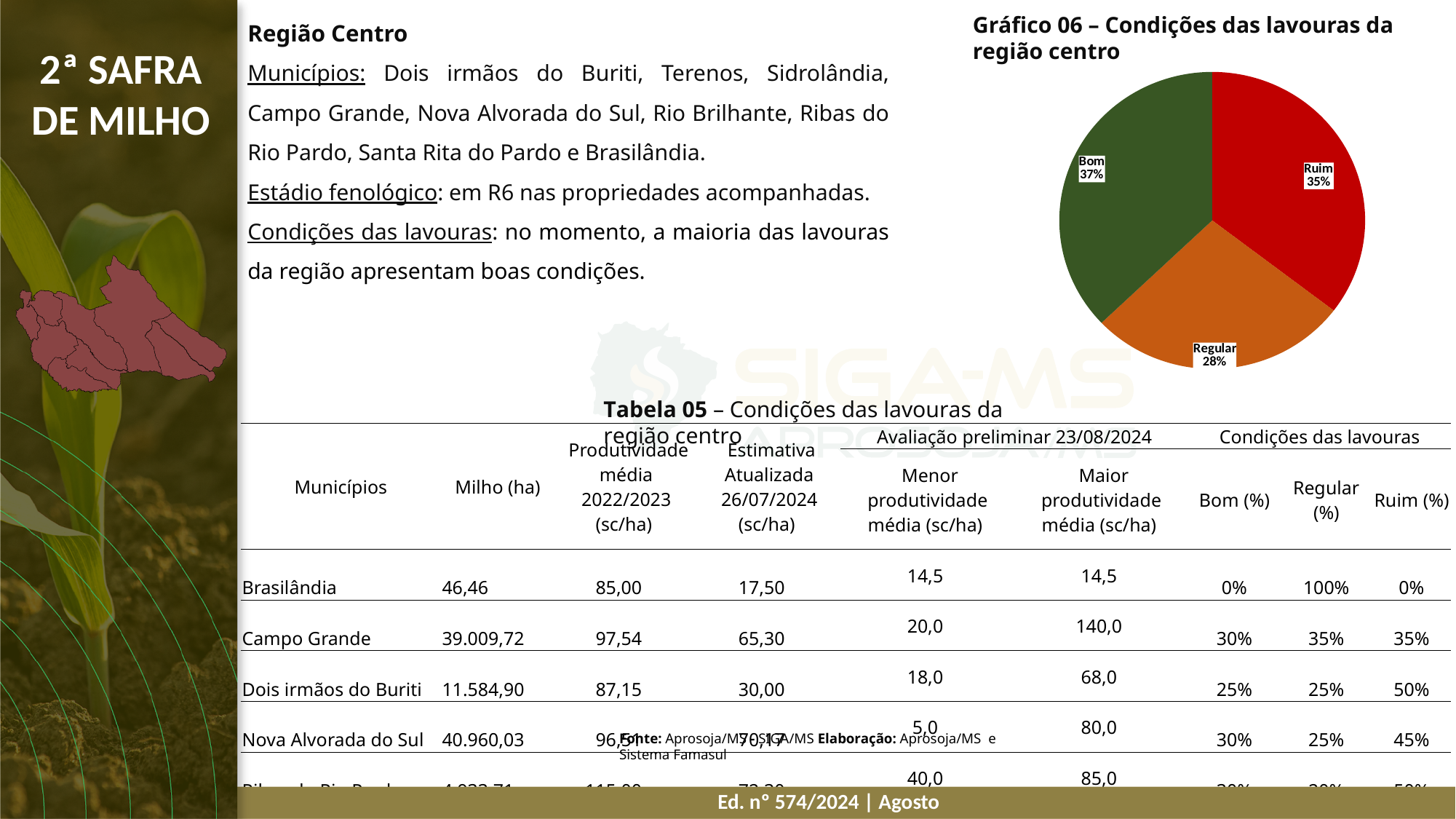
In Gráfico 06, what share of the lavouras is classified as Regular? 28% How many slices does the pie chart in Gráfico 06 have? 3 In Gráfico 06, which condition category has the largest slice? Bom In Gráfico 06, what share of the lavouras is classified as Bom? 37% In Gráfico 06, which slice is larger, Ruim or Regular? Ruim In Gráfico 06, which condition category has the smallest slice? Regular What is the title of the pie chart on the slide? Gráfico 06 – Condições das lavouras da região centro In Gráfico 06, what is the difference in percentage points between the Bom and Regular slices? 9 In Gráfico 06, what is the difference in percentage points between the Ruim and Regular slices? 7 In Gráfico 06, what share of the lavouras is classified as Ruim? 35% In Gráfico 06, what colour is the Ruim slice? red What type of chart is Gráfico 06? pie chart